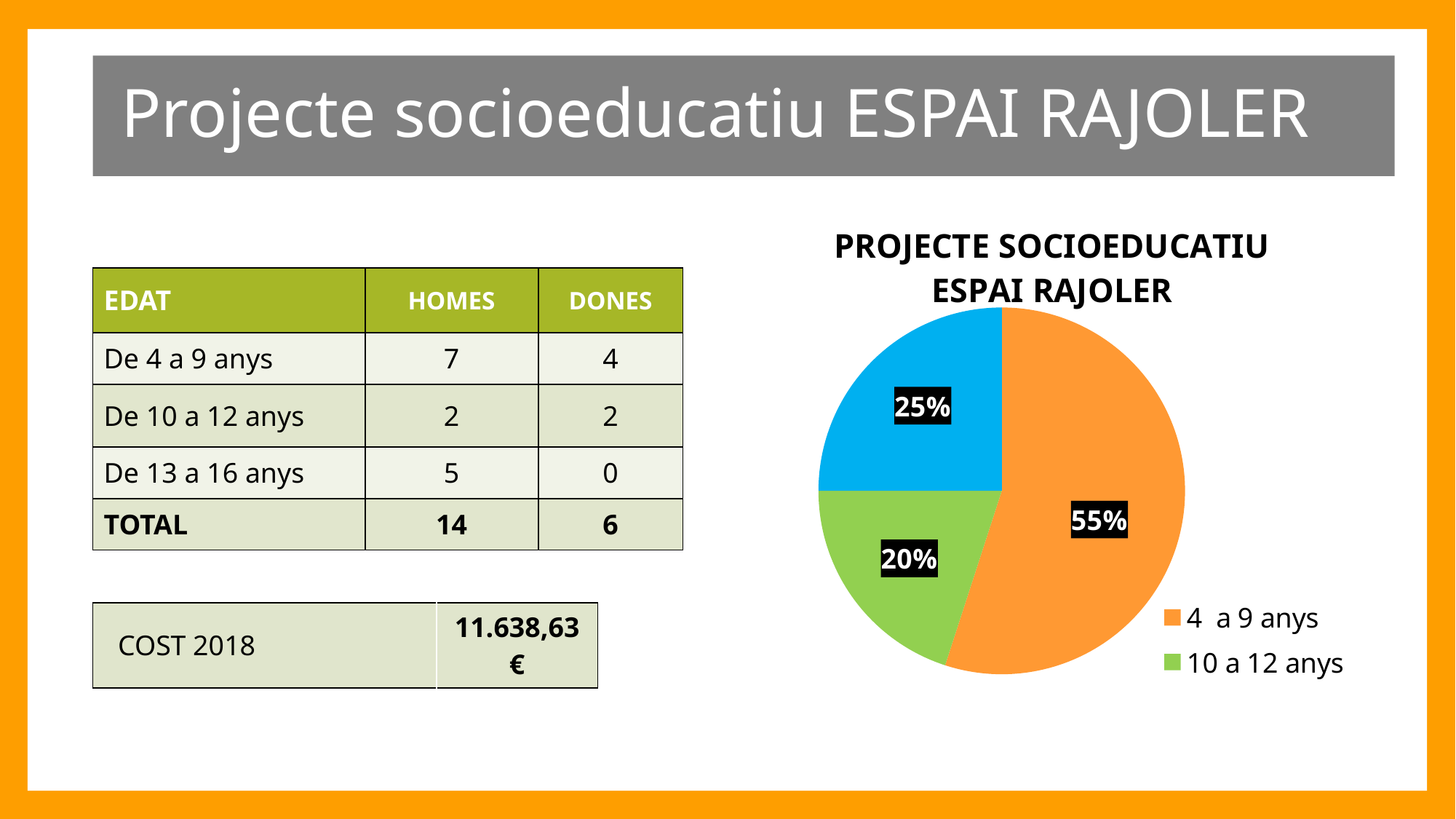
Which slice of the pie chart is the largest? 4 a 9 anys What colour is the '4 a 9 anys' slice in the pie chart? Orange How many slices does the pie chart have? 3 What kind of chart is shown on the slide? Pie chart Which is larger in the pie chart: the '4 a 9 anys' slice or the '10 a 12 anys' slice? 4 a 9 anys By how many percentage points does the '4 a 9 anys' slice exceed the '10 a 12 anys' slice? 35 percentage points By how many percentage points does the blue slice exceed the '10 a 12 anys' slice? 5 percentage points Which slice of the pie chart is the smallest? 10 a 12 anys What percentage of the pie does the '10 a 12 anys' slice represent? 20% What percentage of the pie does the '4 a 9 anys' slice represent? 55% What percentage is shown on the blue slice of the pie chart? 25% What is the title of the pie chart? PROJECTE SOCIOEDUCATIU ESPAI RAJOLER